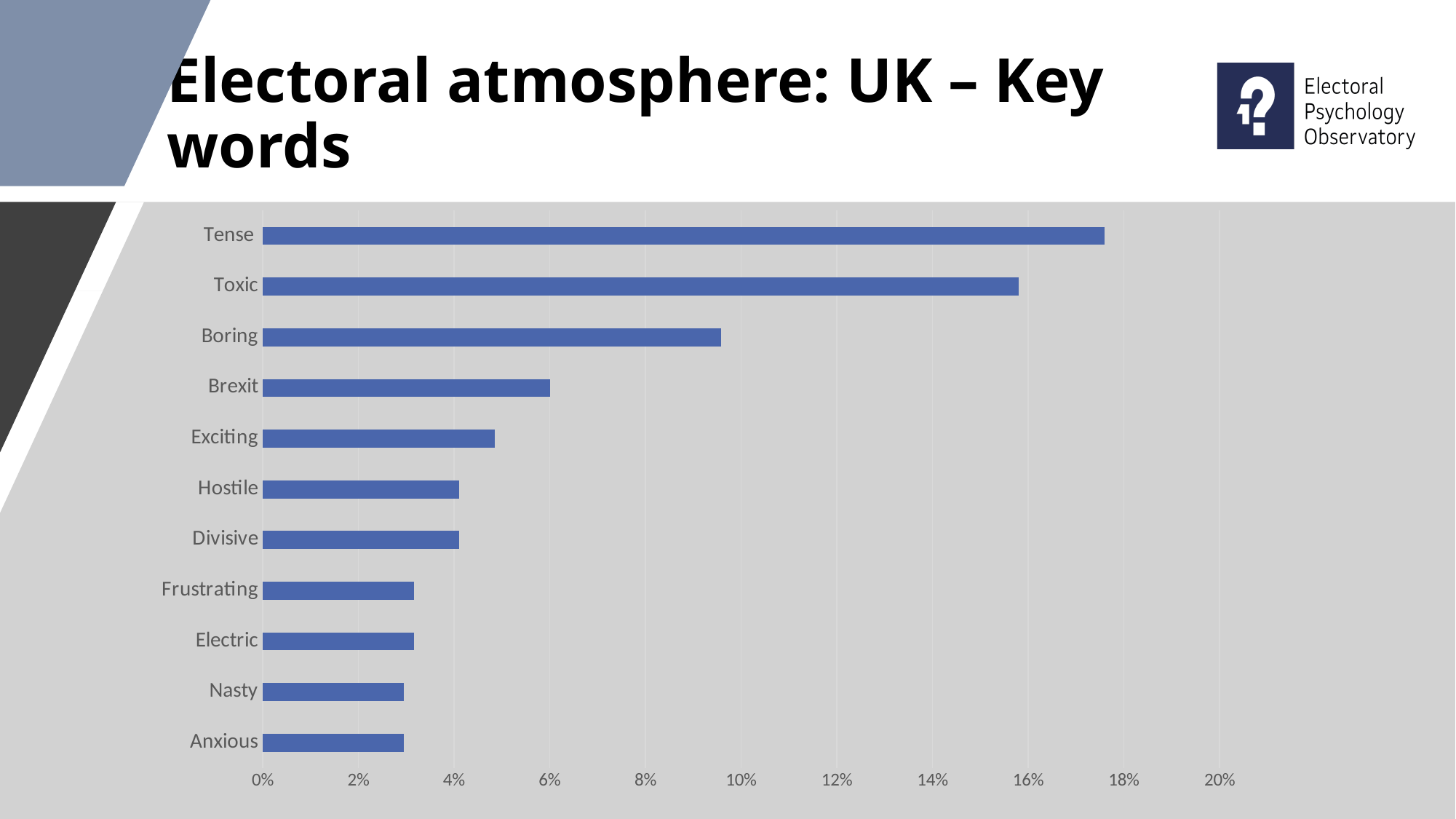
Is the value for Boring greater or less than 8%? greater Which has a larger value, Exciting or Frustrating? Exciting Which has a larger value, Boring or Brexit? Boring Which key word has the highest value in the chart? Tense What is the title of the slide containing the chart? Electoral atmosphere: UK – Key words How many key words (categories) are plotted in the chart? 11 Which has a larger value, Tense or Toxic? Tense Is the value for Anxious greater or less than 4%? less Is the value for Tense greater or less than 16%? greater What kind of chart is shown on the slide? Bar chart